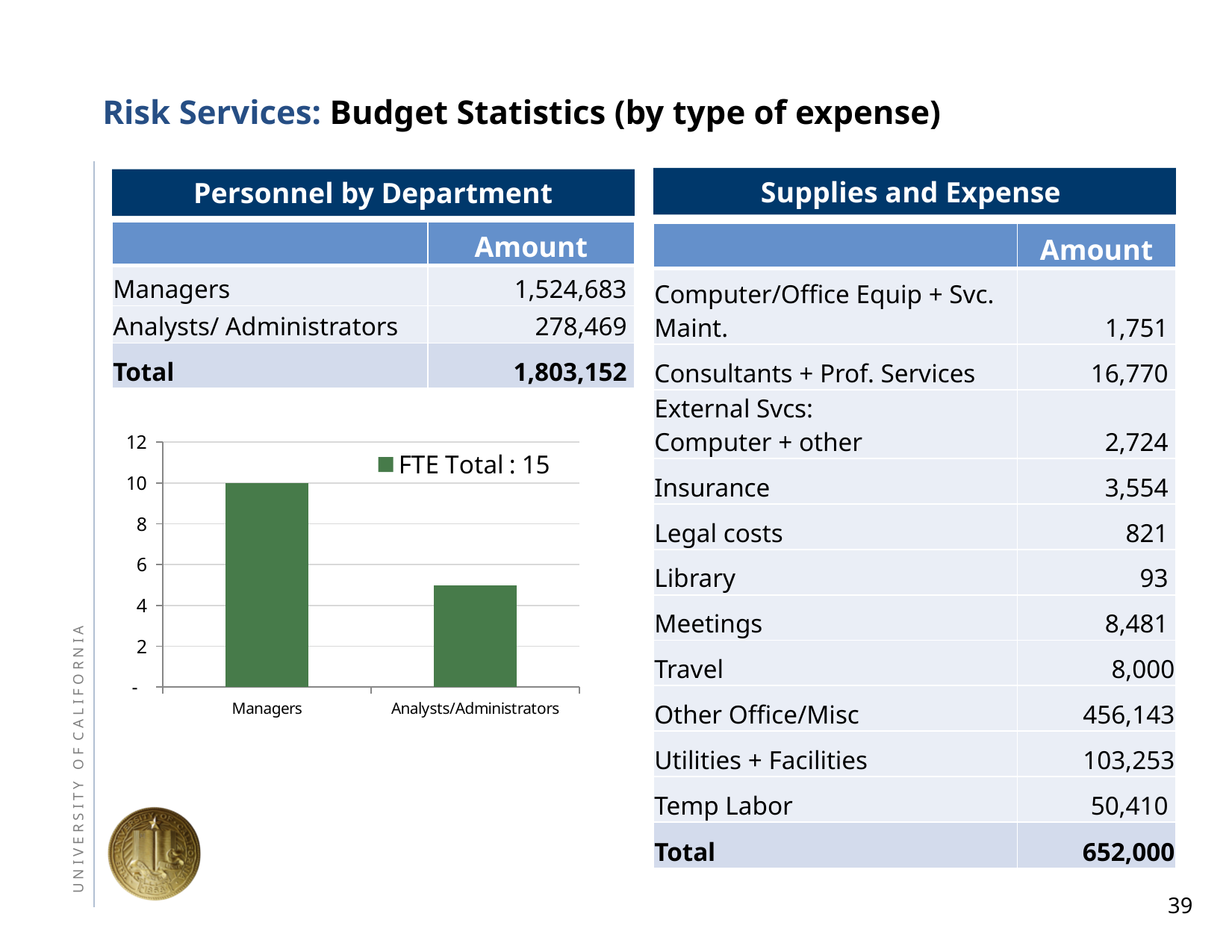
What value does the Managers bar reach on the y axis? 10 Which category has the highest bar in the chart? Managers Which category has the lowest bar in the chart? Analysts/Administrators How many categories are plotted in the bar chart? 2 What colour are the bars in the chart? green Which bar is taller, Managers or Analysts/Administrators? Managers What kind of chart is shown on the slide? bar chart Is the value for Analysts/Administrators greater or less than 4? greater Is the value for Managers greater or less than 12? less What is the legend entry shown in the chart? FTE Total : 15 How many series does the chart legend list? 1 Is the value for Analysts/Administrators greater or less than 6? less